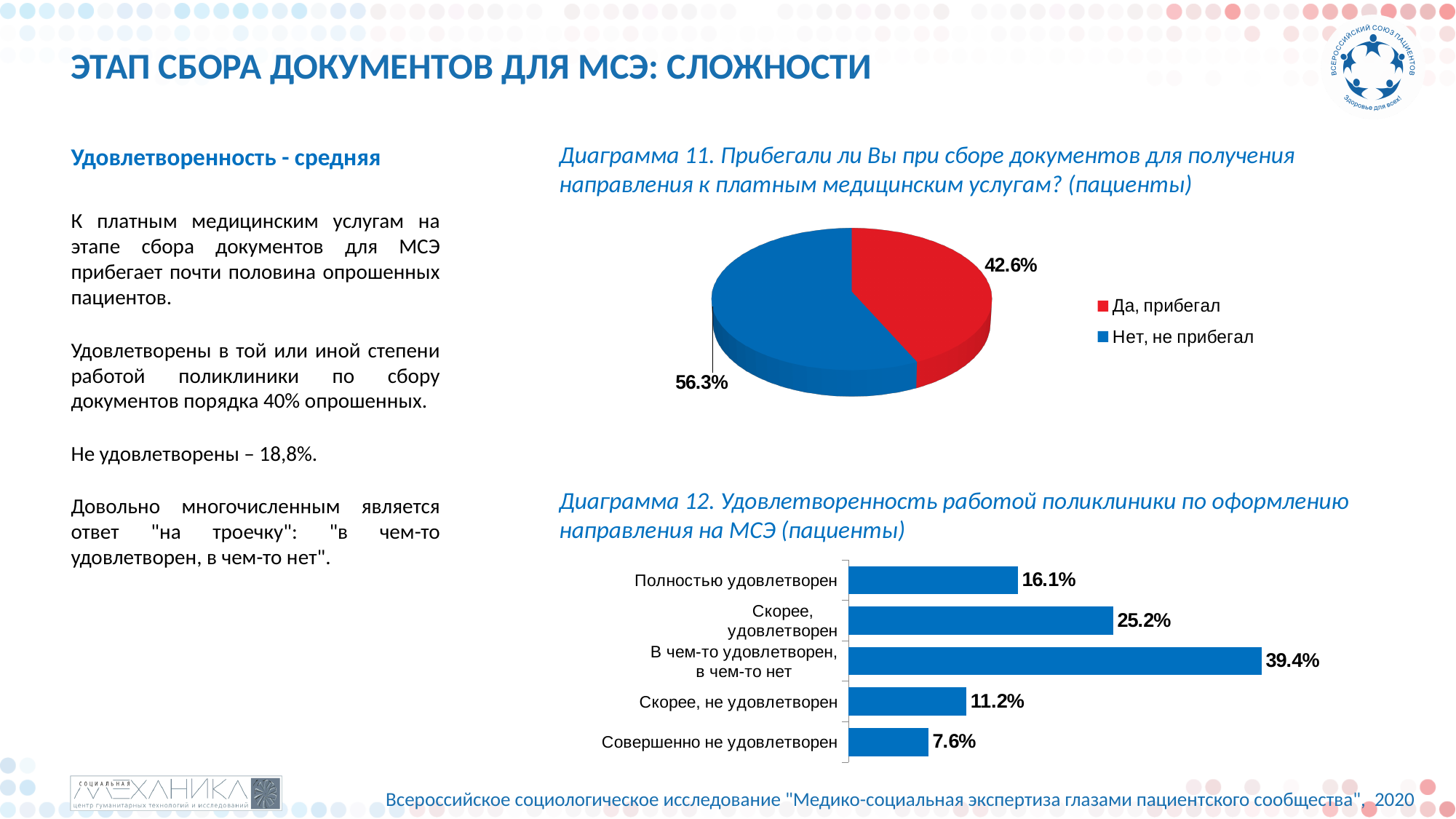
In Диаграмма 11, what share of patients answered "Нет, не прибегал"? 56.3% In Диаграмма 12, which category has the lowest value? Совершенно не удовлетворен In Диаграмма 12, what is the value for "В чем-то удовлетворен, в чем-то нет"? 39.4% In Диаграмма 11, how many entries does the legend list? 2 In Диаграмма 12, what is the value for "Совершенно не удовлетворен"? 7.6% In Диаграмма 11, what share of patients answered "Да, прибегал"? 42.6% In Диаграмма 11, which answer has the larger share? Нет, не прибегал In Диаграмма 12, what is the difference between "Скорее, удовлетворен" and "Полностью удовлетворен"? 9.1% What type of chart is Диаграмма 11? Pie chart In Диаграмма 12, which category has the highest value? В чем-то удовлетворен, в чем-то нет In Диаграмма 12, how many categories are shown? 5 In Диаграмма 11, what is the difference between the "Нет, не прибегал" and "Да, прибегал" shares? 13.7%